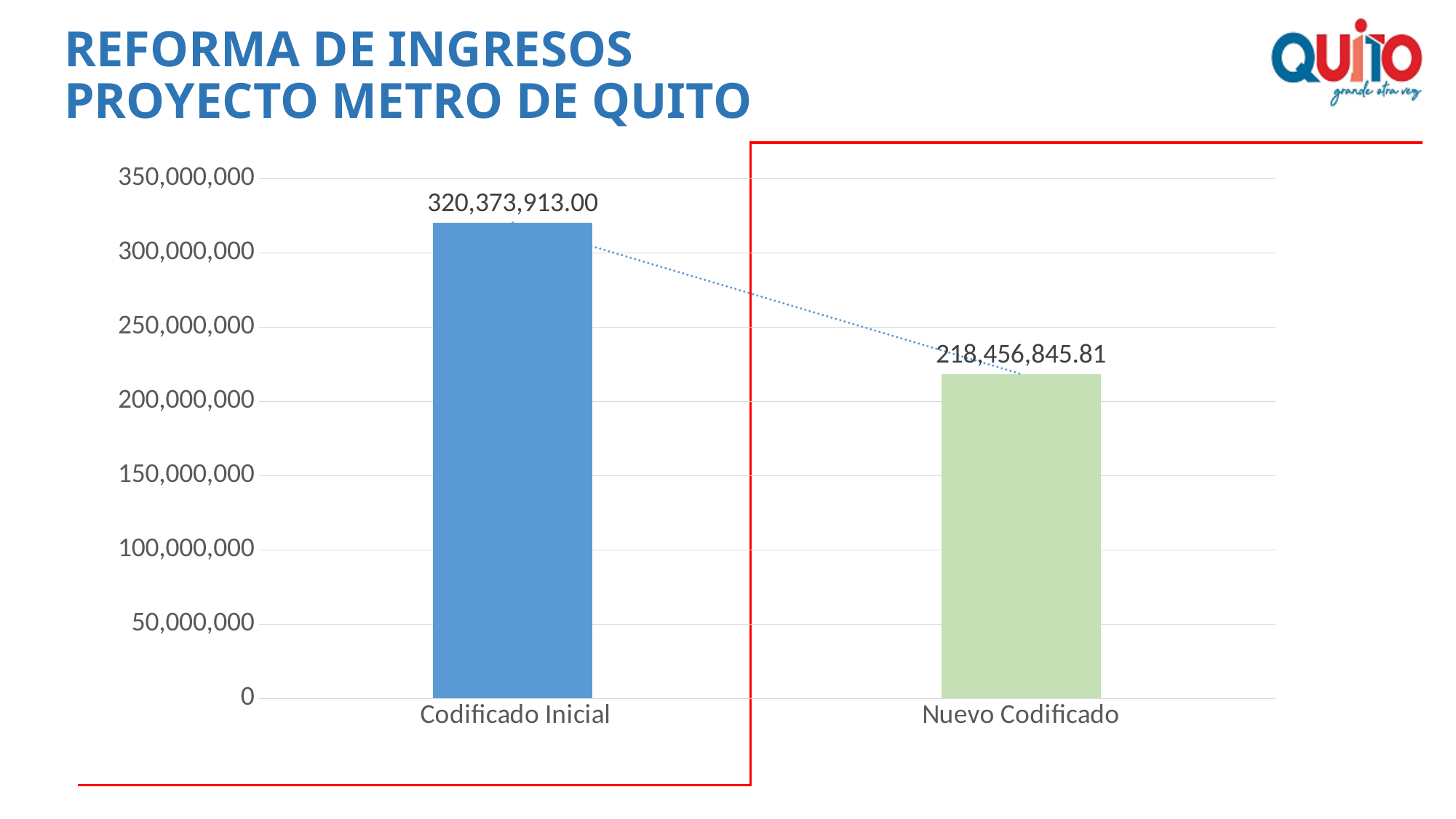
What is the value for Nuevo Codificado? 218,456,845.81 Which category has the lowest value? Nuevo Codificado Which is larger, the value for Codificado Inicial or the value for Nuevo Codificado? Codificado Inicial Is the value for Codificado Inicial greater or less than 300,000,000? greater Do the values rise or fall from Codificado Inicial to Nuevo Codificado? fall What is the difference between the values for Codificado Inicial and Nuevo Codificado? 101,917,067.19 What is the value for Codificado Inicial? 320,373,913.00 What colour is the bar for Nuevo Codificado? green Is the value for Nuevo Codificado greater or less than 250,000,000? less How many categories are shown in the chart? 2 Which category has the highest value? Codificado Inicial What kind of chart is shown on the slide? bar chart